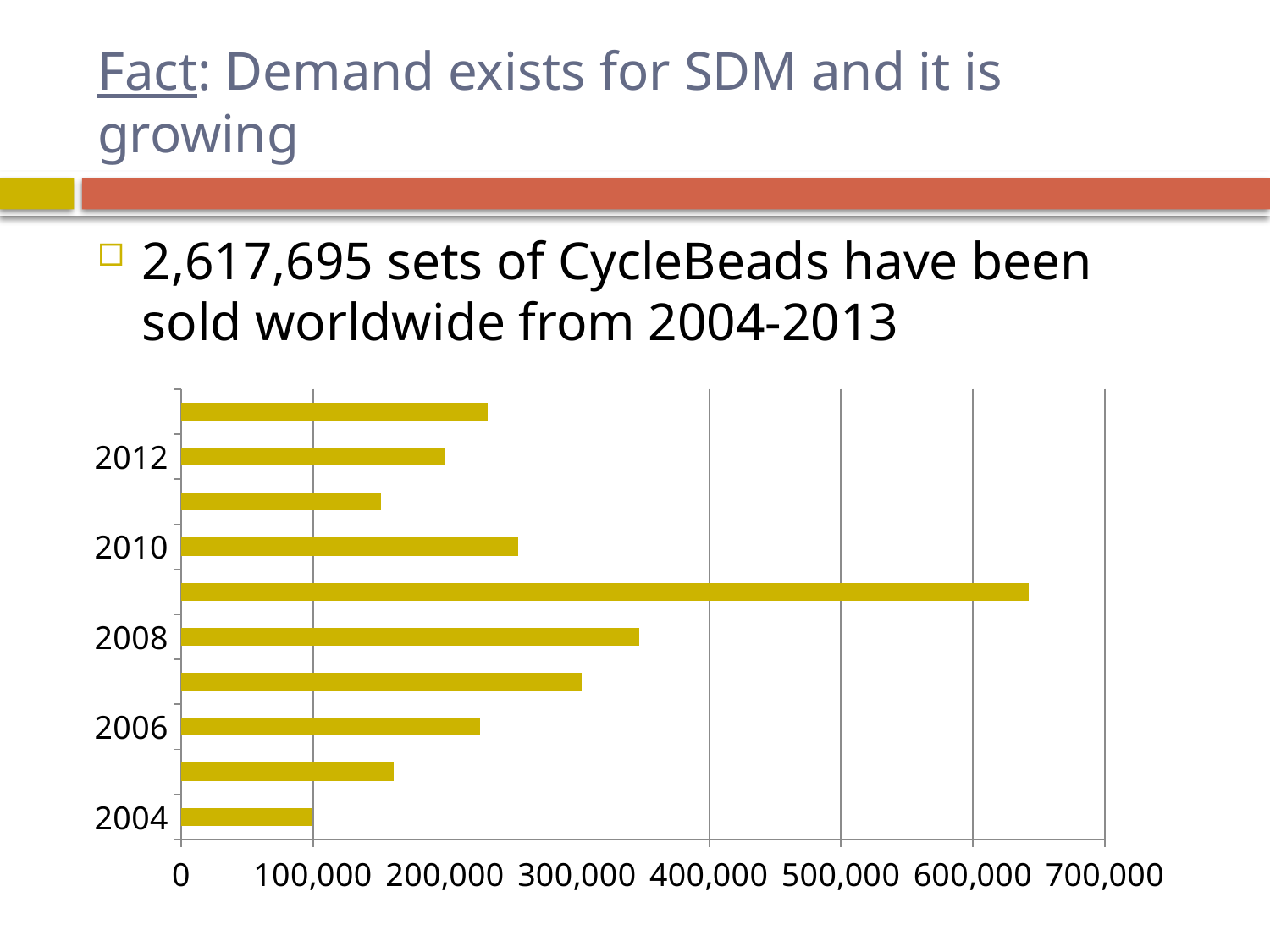
Which is larger, the value for 2010 or the value for 2012? 2010 Is the value for 2006 greater or less than 200,000? greater Is the value for 2010 greater or less than 200,000? greater What kind of chart is shown on the slide? bar chart Which is larger, the value for 2008 or the value for 2006? 2008 Is the value for 2008 greater or less than 300,000? greater What is the highest value shown on the horizontal axis of the chart? 700,000 Which bar is the longest in the chart? the bar between 2008 and 2010 (2009) How many bars does the chart contain? 10 Which labeled year has the shortest bar in the chart? 2004 Do the bar values rise or fall from 2004 to 2008? rise